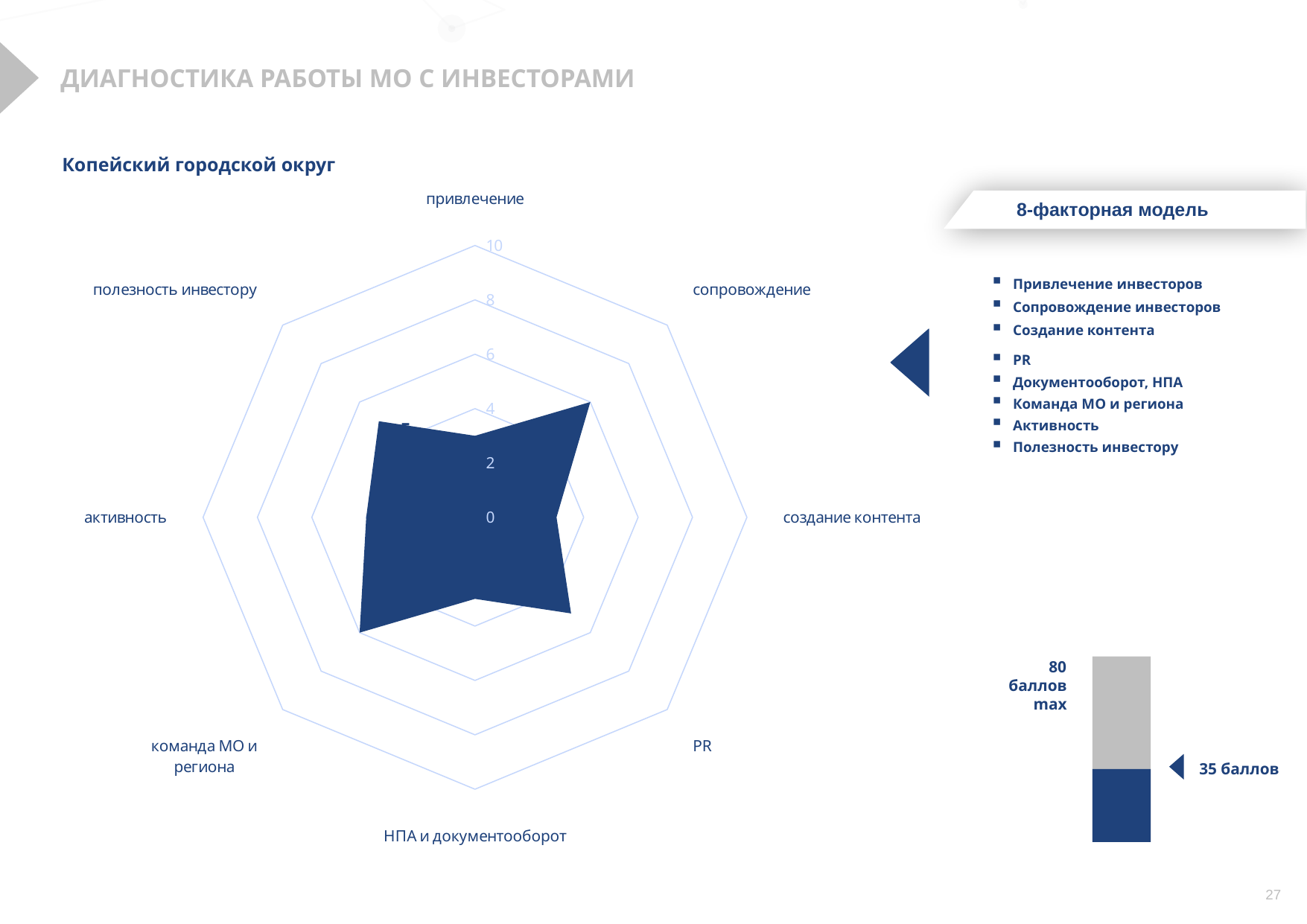
Is the value for PR greater or less than 6? less Is the value for активность greater or less than 6? less What kind of chart is shown on the slide? Radar chart What is the highest value shown on the radar chart's axis scale? 10 How many categories (axes) does the radar chart have? 8 Which has the larger value, команда МО и региона or PR? команда МО и региона Is the value for привлечение greater or less than 4? less Which has the larger value, сопровождение or привлечение? сопровождение Which municipality is the radar chart about, according to the heading above it? Копейский городской округ